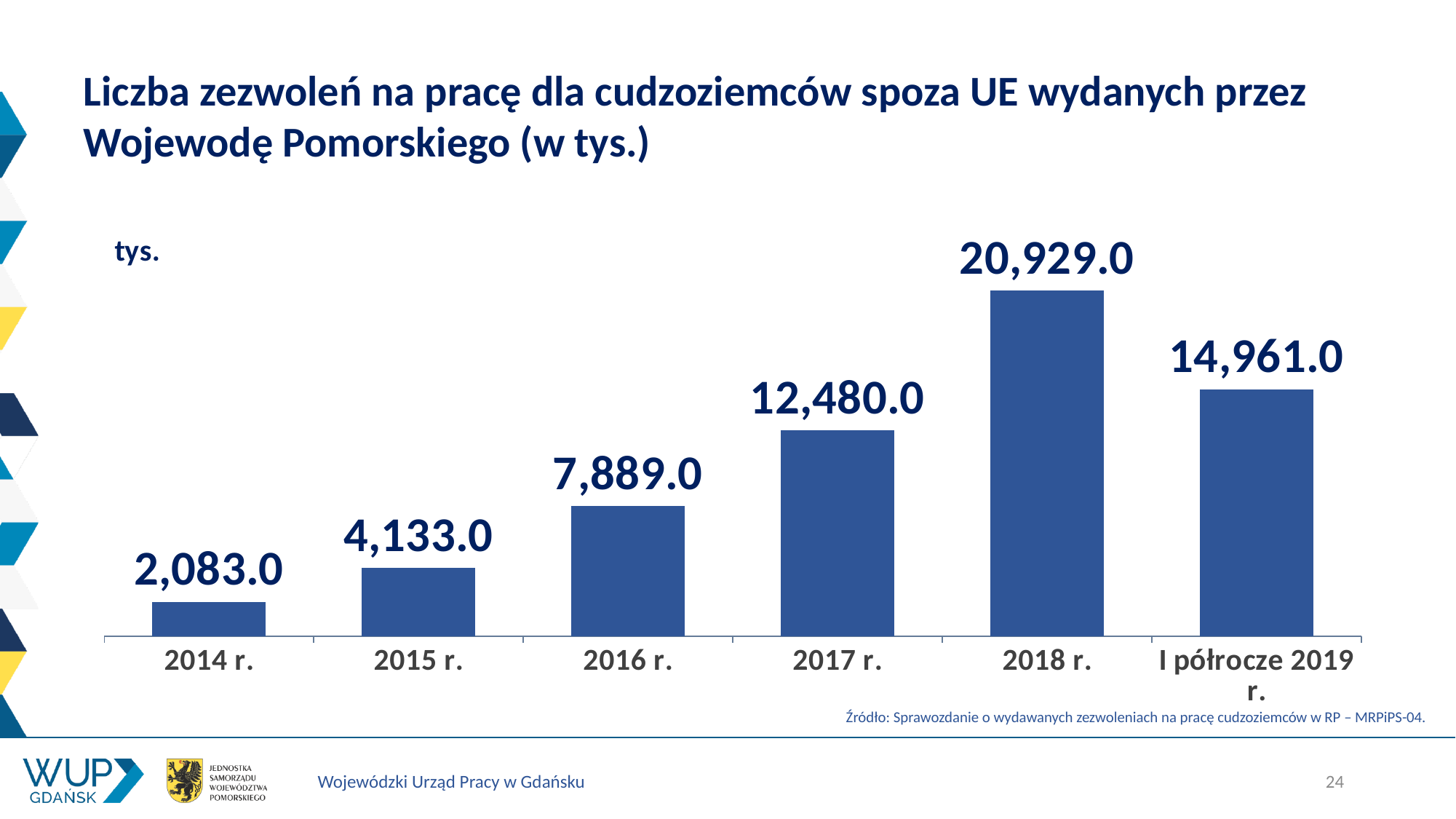
What is the difference between the values for 2018 r. and 2017 r.? 8,449.0 What is the value for 2017 r.? 12,480.0 What is the difference between the values for 2016 r. and 2015 r.? 3,756.0 Which category has the lowest value? 2014 r. Do the values rise or fall from 2014 r. to 2018 r.? rise What kind of chart is this? bar chart Which category has the highest value? 2018 r. How many categories are shown on the x axis? 6 Which is larger, the value for 2018 r. or the value for I półrocze 2019 r.? 2018 r. What is the value for 2014 r.? 2,083.0 What unit label is shown above the chart's vertical axis? tys. What is the value for I półrocze 2019 r.? 14,961.0